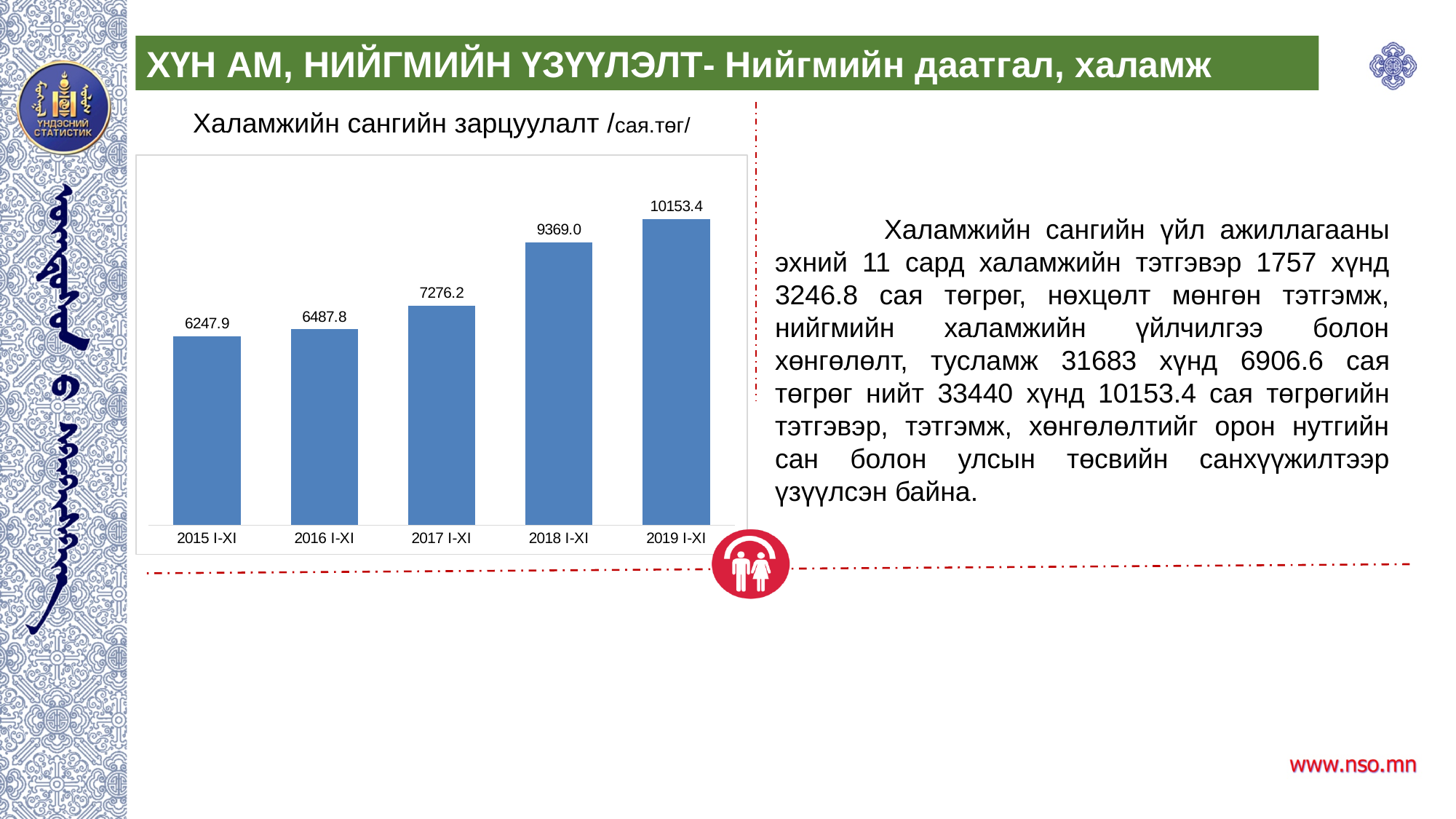
How many bars are shown in the chart? 5 What is the value for 2017 I-XI? 7276.2 What kind of chart is shown on the slide? Bar chart Which period has the highest value? 2019 I-XI What is the value for 2019 I-XI? 10153.4 What is the value for 2015 I-XI? 6247.9 Which period has the lowest value? 2015 I-XI Which is larger, the value for 2016 I-XI or the value for 2017 I-XI? 2017 I-XI What is the difference between the values for 2019 I-XI and 2018 I-XI? 784.4 Do the values rise or fall from 2015 I-XI to 2019 I-XI? Rise What is the value for 2018 I-XI? 9369.0 What is the difference between the values for 2018 I-XI and 2017 I-XI? 2092.8